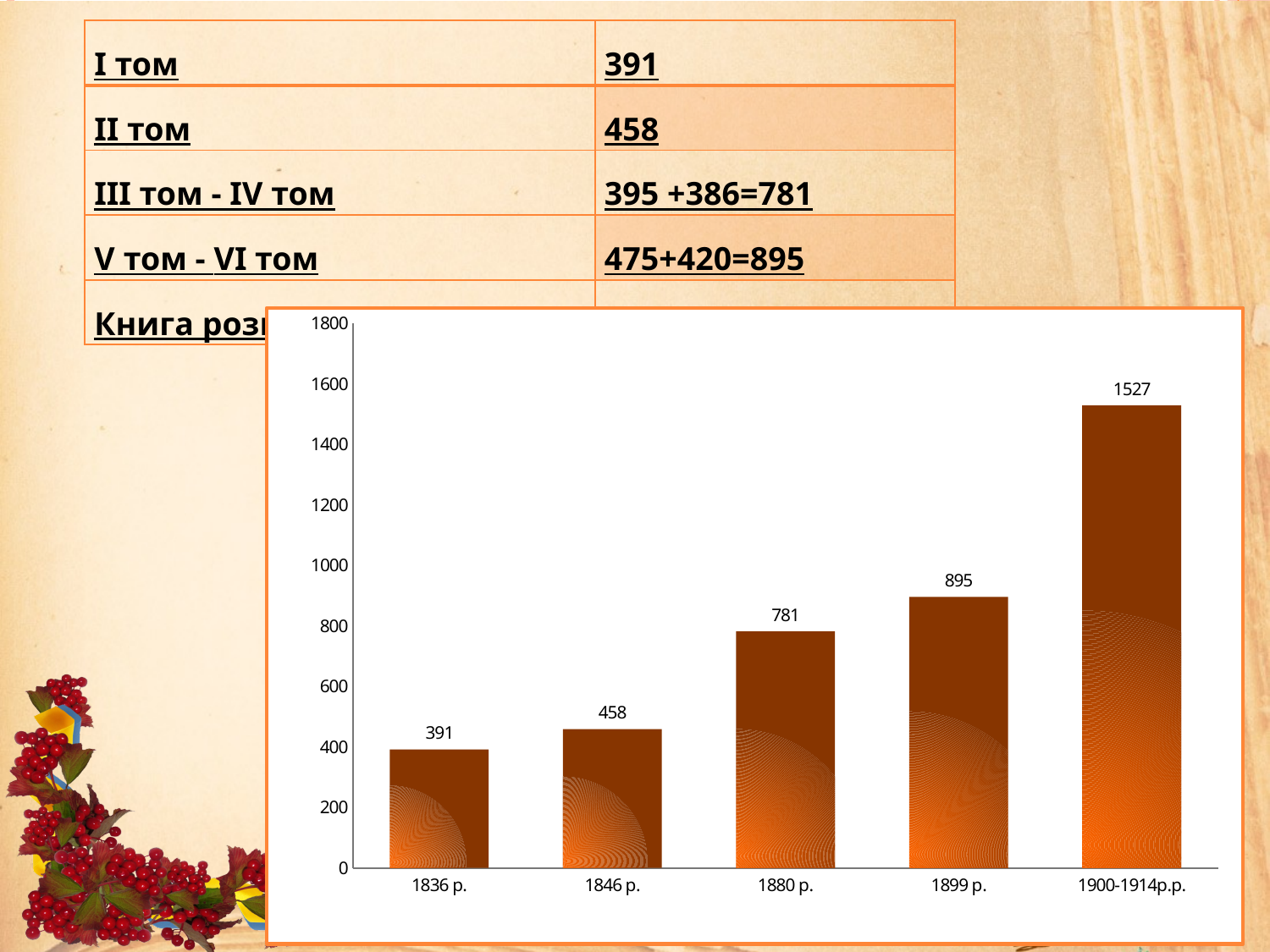
What is the difference between the values for 1900-1914р.р. and 1899 р.? 632 Which is larger, the value for 1846 р. or the value for 1836 р.? 1846 р. Which category has the lowest value? 1836 р. Is the value for 1899 р. greater or less than 1000? less Which category has the highest value? 1900-1914р.р. How many categories are shown on the x axis? 5 What is the difference between the values for 1899 р. and 1880 р.? 114 Do the values rise or fall from left to right along the x axis? rise What is the value for 1836 р.? 391 What kind of chart is shown on the slide? bar chart What is the value for 1900-1914р.р.? 1527 What is the value for 1880 р.? 781